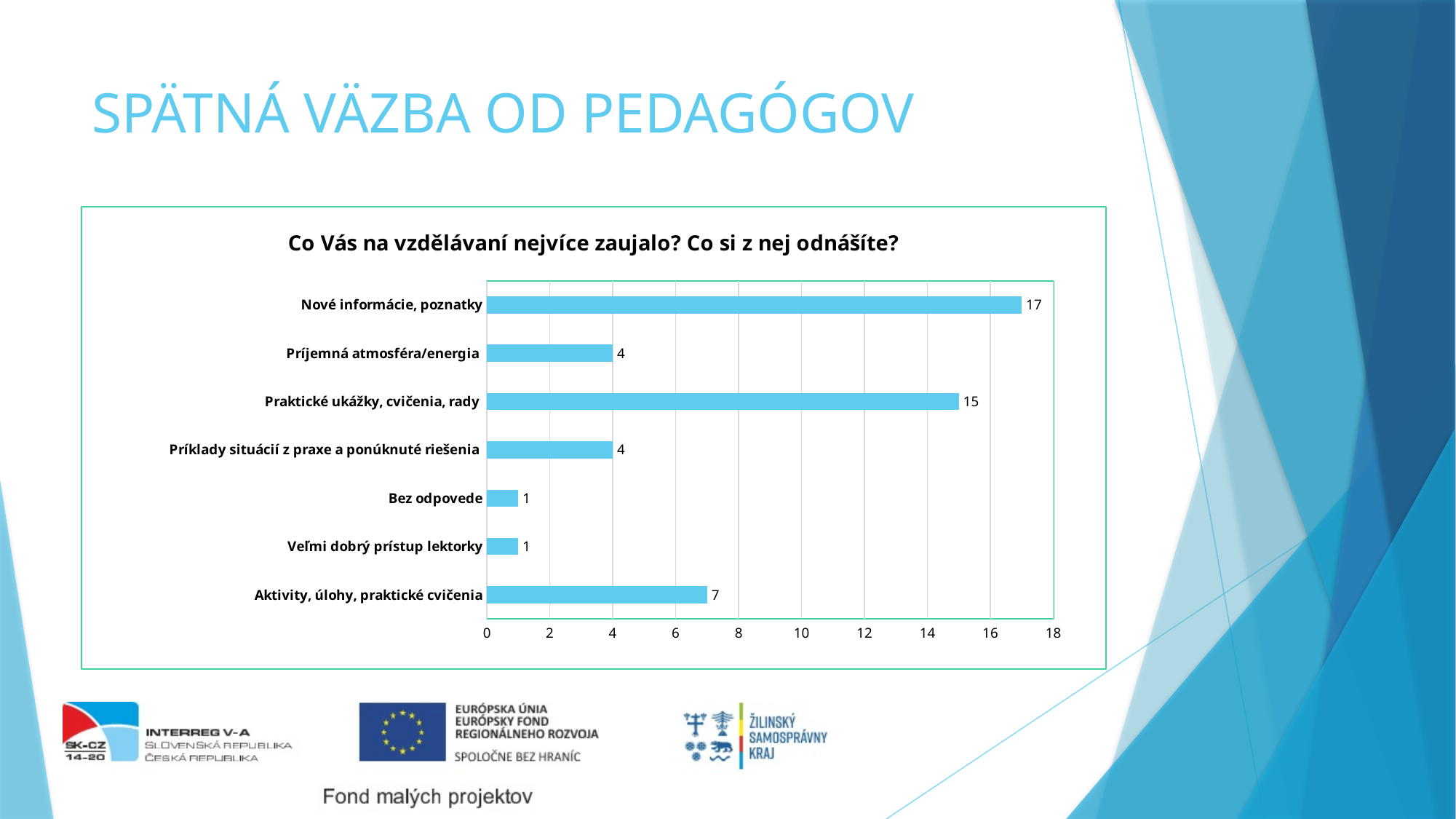
Which is larger: the value for "Aktivity, úlohy, praktické cvičenia" or the value for "Príklady situácií z praxe a ponúknuté riešenia"? Aktivity, úlohy, praktické cvičenia What kind of chart is shown on the slide? bar chart Is the value for "Praktické ukážky, cvičenia, rady" greater or less than 10? greater Which category has the highest value? Nové informácie, poznatky How many categories are shown in the chart? 7 What is the value for "Nové informácie, poznatky"? 17 What is the value for "Príjemná atmosféra/energia"? 4 What is the difference between the values for "Nové informácie, poznatky" and "Praktické ukážky, cvičenia, rady"? 2 What is the value for "Bez odpovede"? 1 What is the title of the chart? Co Vás na vzdělávaní nejvíce zaujalo? Co si z nej odnášíte? What is the value for "Aktivity, úlohy, praktické cvičenia"? 7 What is the value for "Praktické ukážky, cvičenia, rady"? 15